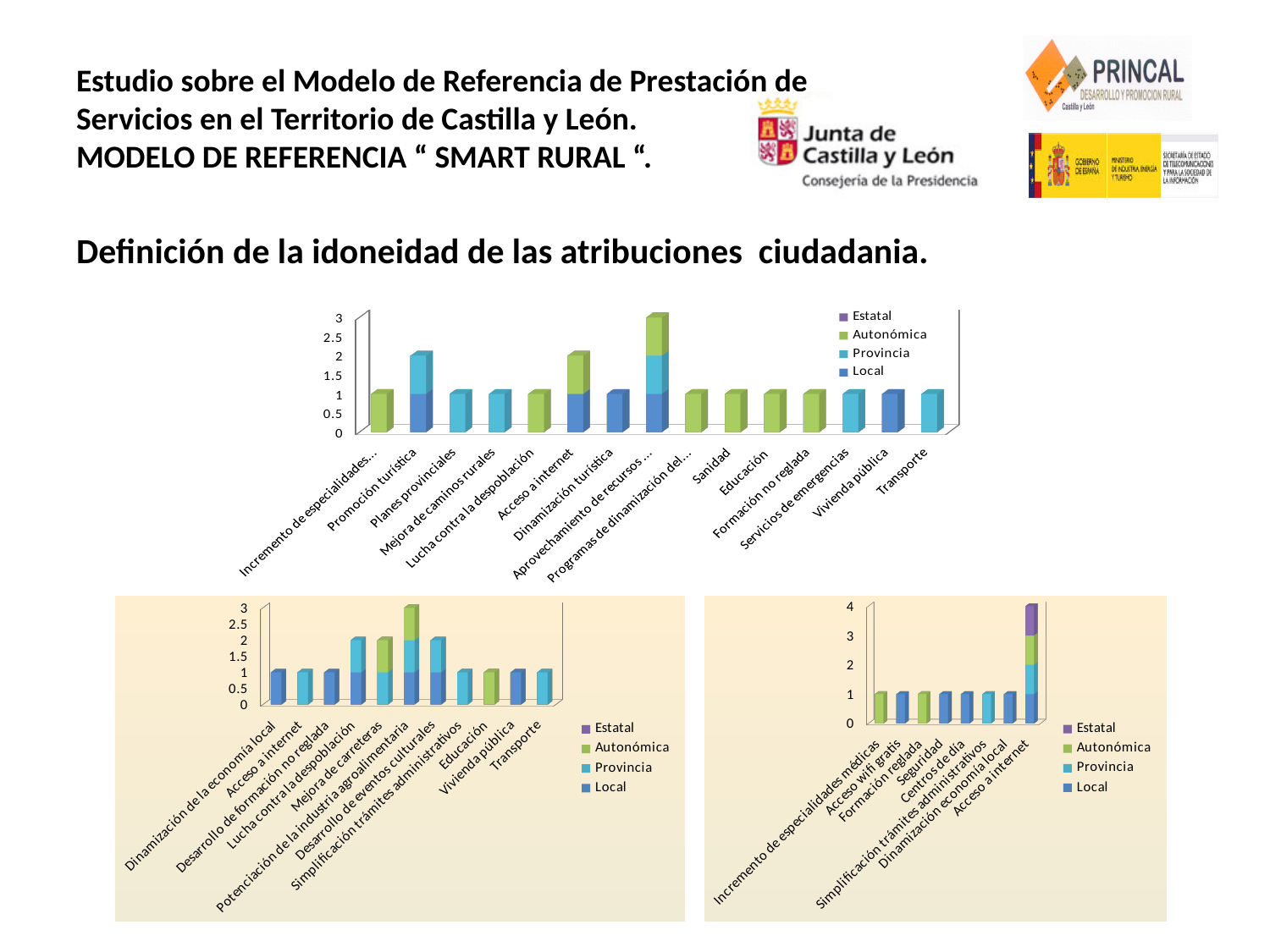
In the bottom-left chart, which category has the highest total bar? Potenciación de la industria agroalimentaria In the top chart, how many categories are plotted on the x axis? 15 In the bottom-left chart, what is the total height of the stacked bar for Lucha contra la despoblación? 2 What kind of chart is the bottom-left chart? Bar chart In the top chart, which series is the only one contributing to the bar for Sanidad? Autonómica In the bottom-right chart, which category has the highest total bar? Acceso a internet In the bottom-left chart, how many categories are plotted? 11 In the top chart, how many series does the legend list? 4 In the top chart, what is the total height of the stacked bar for Promoción turística? 2 In the bottom-right chart, what is the total height of the stacked bar for Acceso a internet? 4 In the top chart, which category has the highest total bar? Aprovechamiento de recursos ... In the bottom-right chart, which is larger: the total for Acceso a internet or the total for Seguridad? Acceso a internet